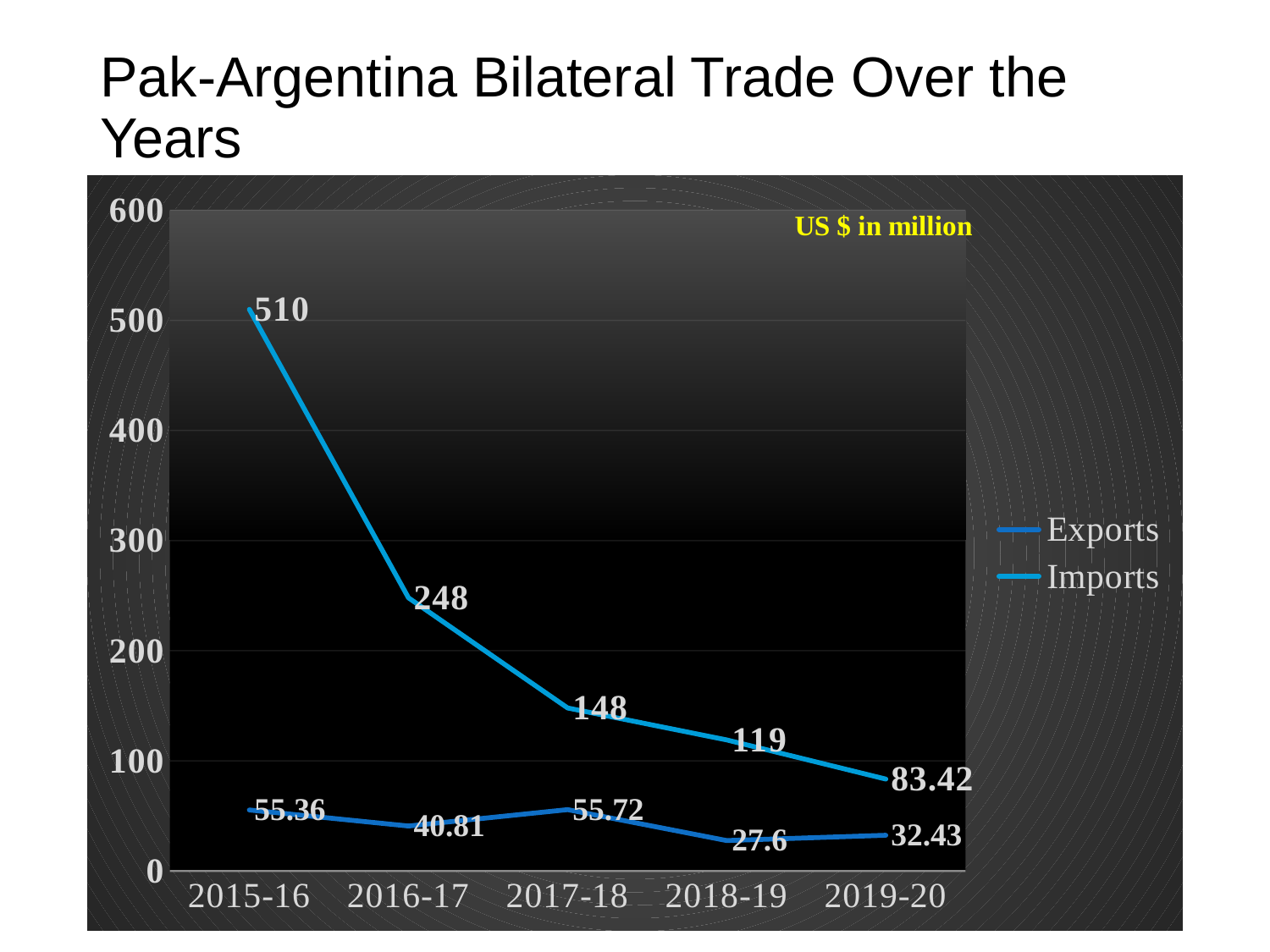
What is the value of Imports in 2015-16? 510 Which is larger in 2017-18, Imports or Exports? Imports What is the value of Imports in 2019-20? 83.42 What is the value of Exports in 2018-19? 27.6 What kind of chart is shown? Line chart In which year are Imports highest? 2015-16 Is the value for Imports in 2018-19 greater or less than 100? greater How many years are shown on the x axis? 5 In which year are Exports lowest? 2018-19 What is the difference between Imports and Exports in 2016-17? 207.19 Do Imports rise or fall from 2015-16 to 2019-20? Fall How many series does the legend list? 2